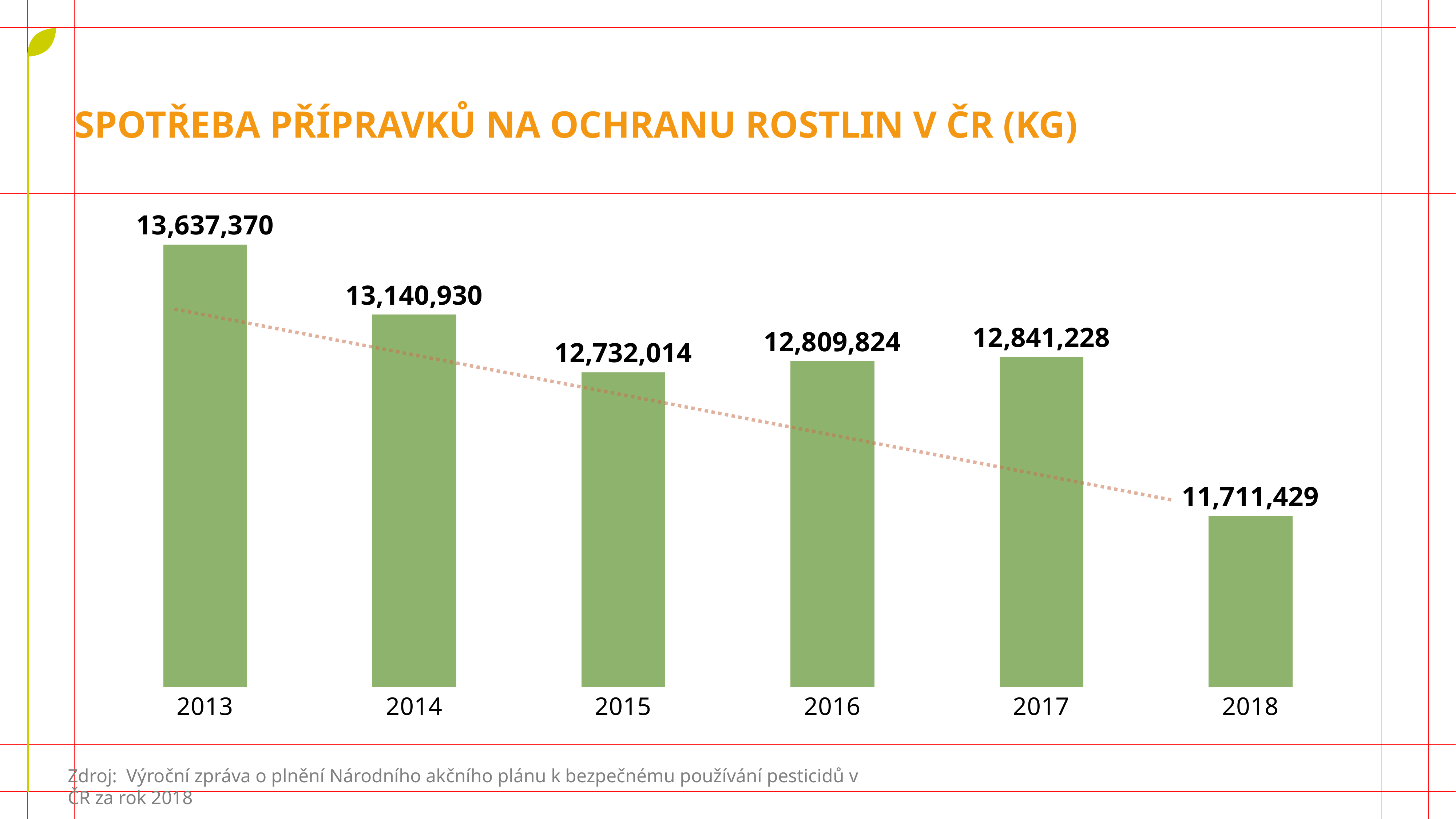
What is the value for 2018? 11,711,429 Which year has the lowest value? 2018 What is the value for 2013? 13,637,370 Do the values generally rise or fall from 2013 to 2018? Fall What is the difference between the values for 2013 and 2014? 496,440 What kind of chart is shown on the slide? Bar chart Which is larger, the value for 2016 or the value for 2017? 2017 Which year has the highest value? 2013 What is the difference between the values for 2017 and 2018? 1,129,799 What is the title of the chart? SPOTŘEBA PŘÍPRAVKŮ NA OCHRANU ROSTLIN V ČR (KG) What is the value for 2015? 12,732,014 How many years are shown on the x axis? 6